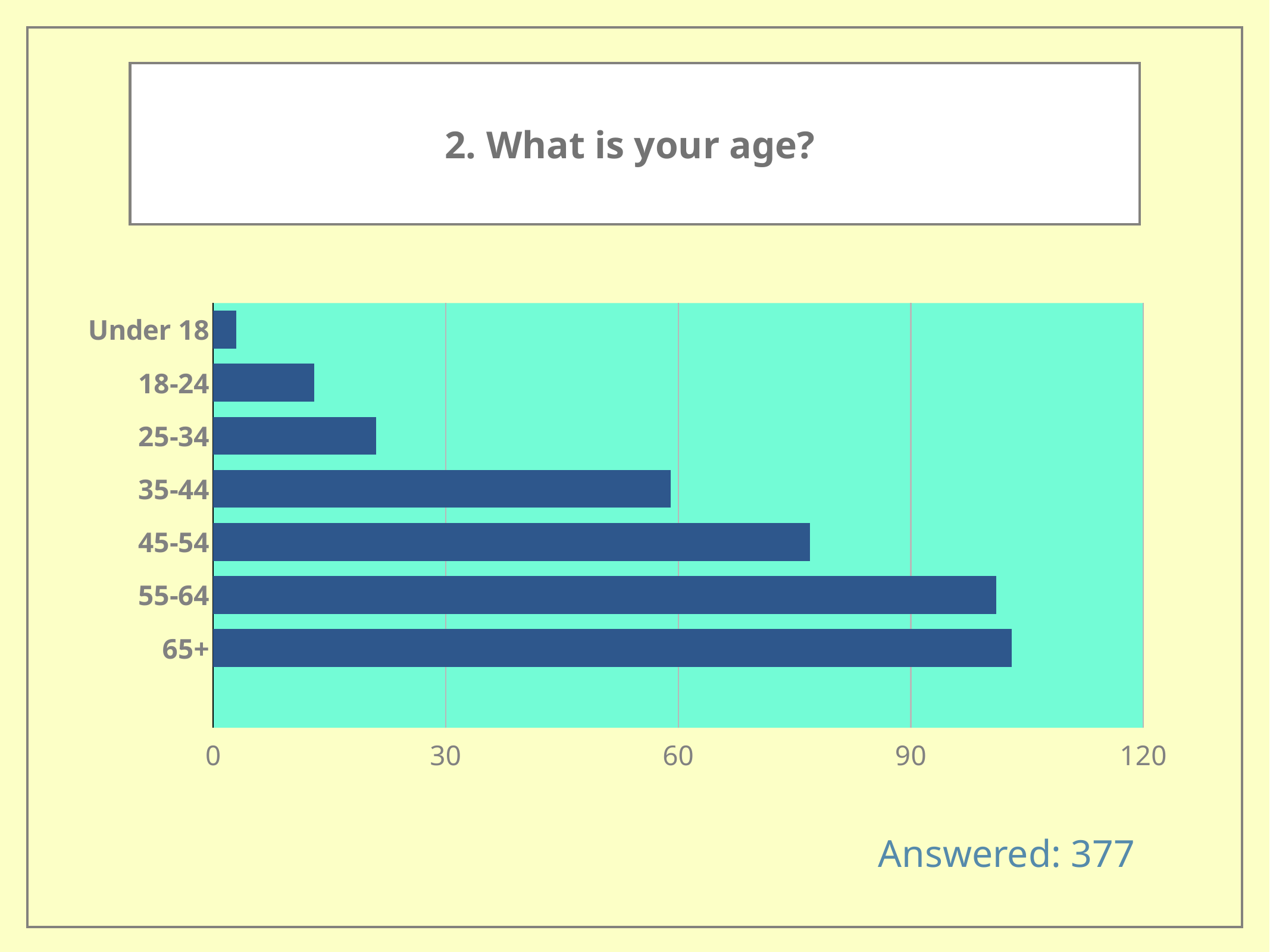
What is the title of the chart? 2. What is your age? Which has the larger value, 35-44 or 45-54? 45-54 Is the value for 45-54 greater or less than 60? greater Is the value for 25-34 greater or less than 30? less Is the value for 55-64 greater or less than 90? greater Which age category has the lowest value in the chart? Under 18 How many age categories are plotted in the chart? 7 Do the values rise or fall going from the Under 18 category down to the 65+ category? rise What kind of chart is shown on the slide? bar chart Which has the larger value, 18-24 or 25-34? 25-34